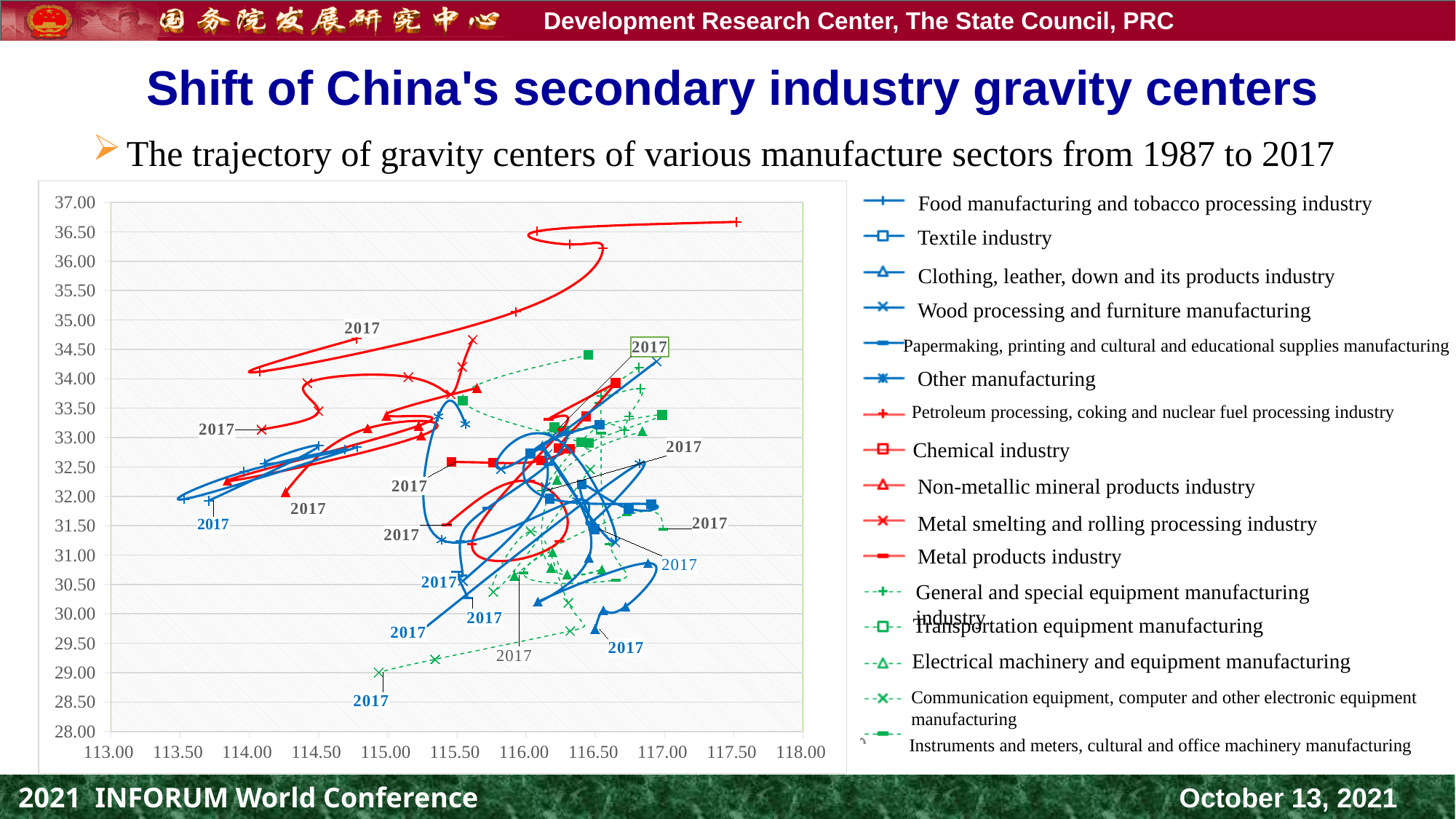
What is the maximum value shown on the vertical axis? 37.00 Which series has the lowest point on the vertical axis? Communication equipment, computer and other electronic equipment manufacturing What is the title of the slide containing the chart? Shift of China's secondary industry gravity centers What period do the trajectories in the chart cover, according to the slide? 1987 to 2017 Which series reaches a higher vertical-axis value: Petroleum processing, coking and nuclear fuel processing industry or Textile industry? Petroleum processing, coking and nuclear fuel processing industry Which series reaches a lower vertical-axis value: Communication equipment, computer and other electronic equipment manufacturing or Chemical industry? Communication equipment, computer and other electronic equipment manufacturing Is the highest point of the Petroleum processing, coking and nuclear fuel processing industry trajectory greater or less than 36.00 on the vertical axis? greater What kind of chart is shown on the slide? Line chart (trajectory/scatter lines) How many series does the legend list? 16 Which series reaches the highest value on the vertical axis? Petroleum processing, coking and nuclear fuel processing industry Is the 2017 point of the Communication equipment, computer and other electronic equipment manufacturing series greater or less than 29.50 on the vertical axis? less Is the highest point of the Petroleum processing, coking and nuclear fuel processing industry trajectory greater or less than 117.00 on the horizontal axis? greater